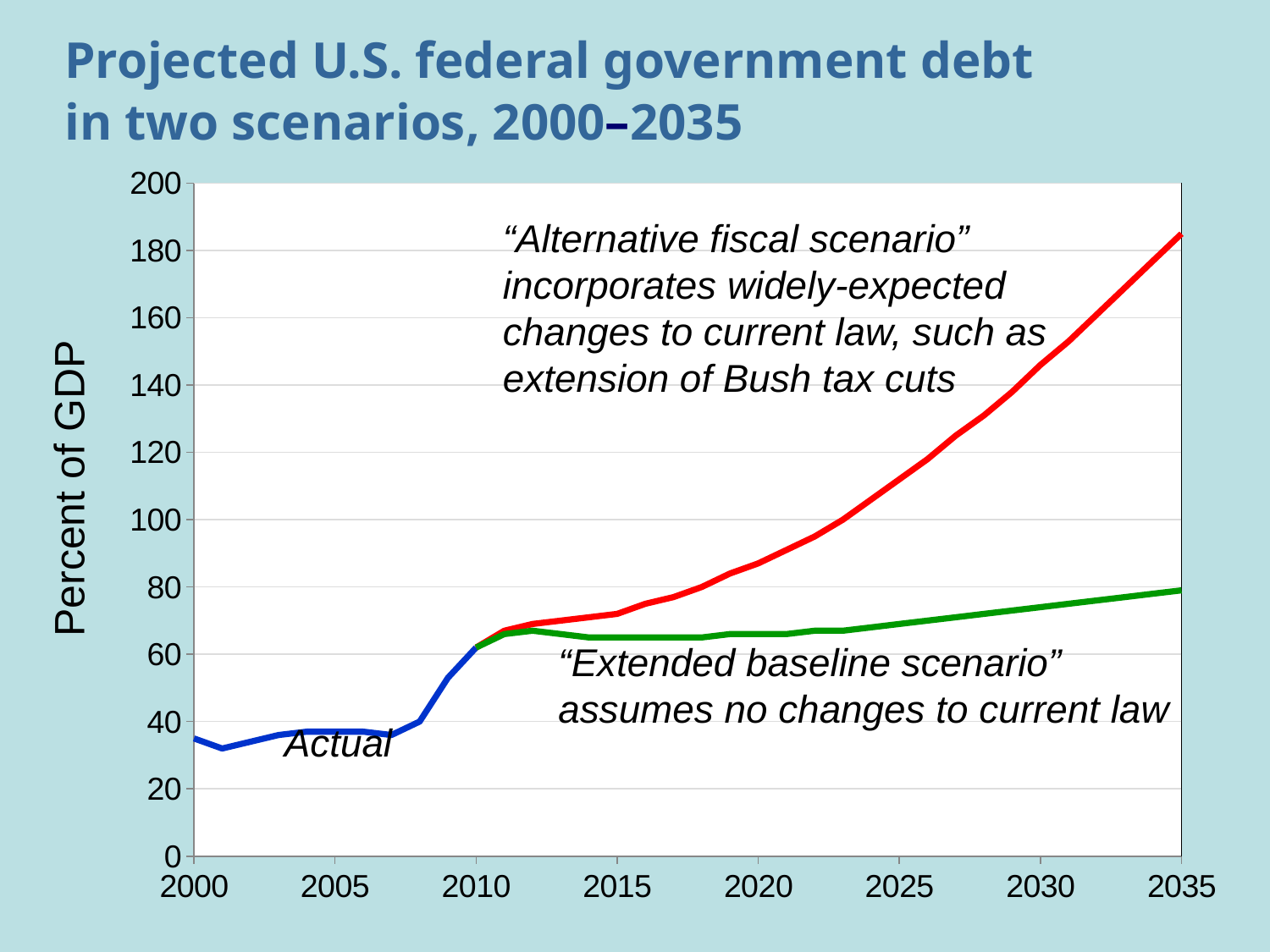
What kind of chart is shown on the slide? line chart How many lines are plotted on the chart? 3 Does the "Alternative fiscal scenario" line rise or fall between 2015 and 2035? rise What is the title of the chart on the slide? Projected U.S. federal government debt in two scenarios, 2000–2035 Is the value of the "Alternative fiscal scenario" line in 2035 greater or less than 160? greater In 2035, which line is higher: the "Alternative fiscal scenario" or the "Extended baseline scenario"? Alternative fiscal scenario What is the label on the vertical axis of the chart? Percent of GDP Is the value of the "Actual" line in 2000 greater or less than 40? less Is the value of the "Alternative fiscal scenario" line in 2025 greater or less than 100? greater